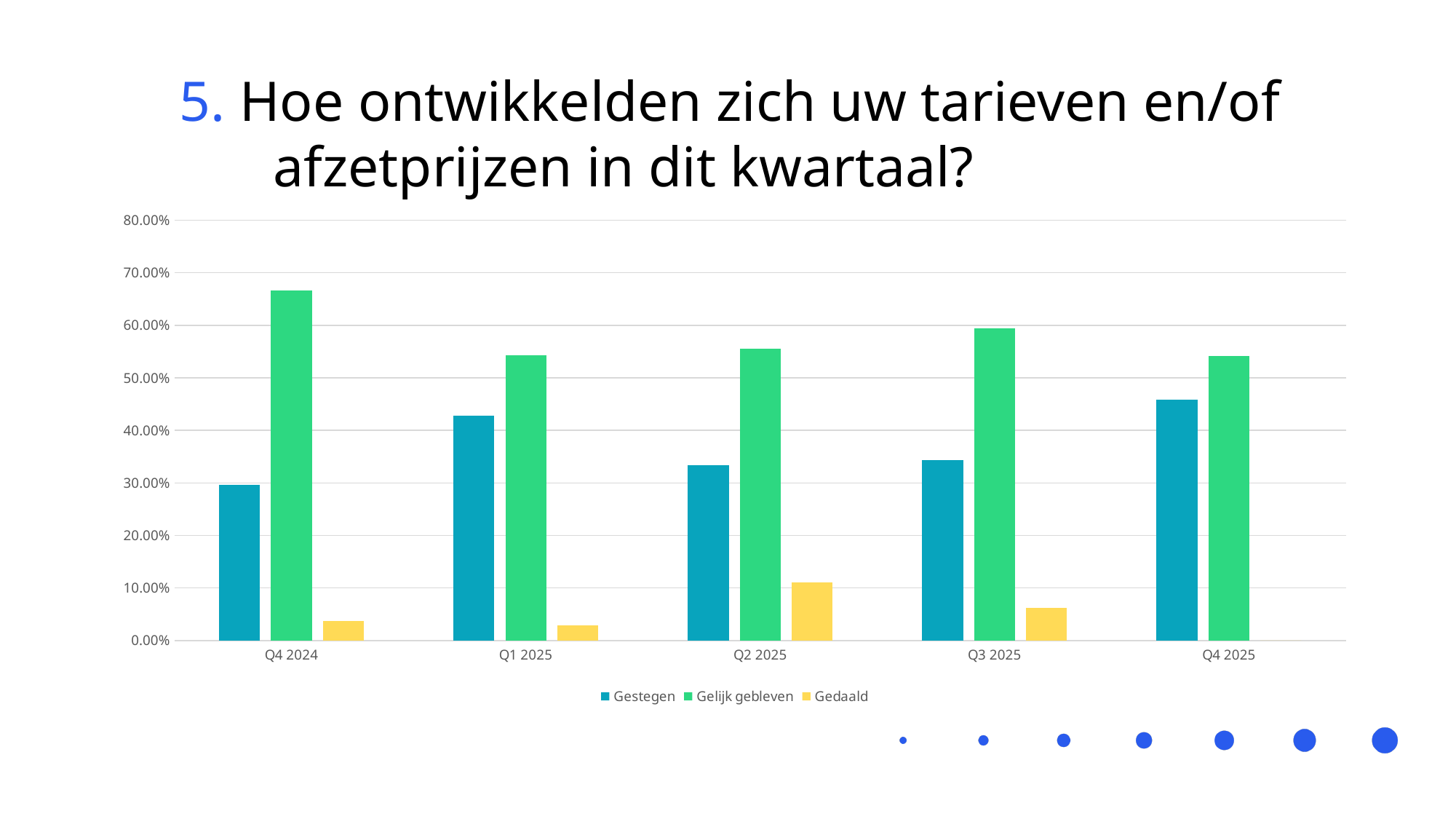
How many quarters are shown on the x axis? 5 Is the value for Gedaald in Q3 2025 greater or less than 10.00%? less Which quarter has the lowest value for Gestegen? Q4 2024 In Q2 2025, which is larger: Gestegen or Gelijk gebleven? Gelijk gebleven Is the value for Gestegen in Q1 2025 greater or less than 40.00%? greater Does the value for Gelijk gebleven rise or fall from Q4 2024 to Q1 2025? fall Is the value for Gelijk gebleven in Q4 2024 greater or less than 60.00%? greater Which quarter has the highest value for Gelijk gebleven? Q4 2024 What kind of chart is shown on the slide? bar chart Which series is shown in yellow in the legend? Gedaald Which quarter has the highest value for Gedaald? Q2 2025 How many series does the legend list? 3